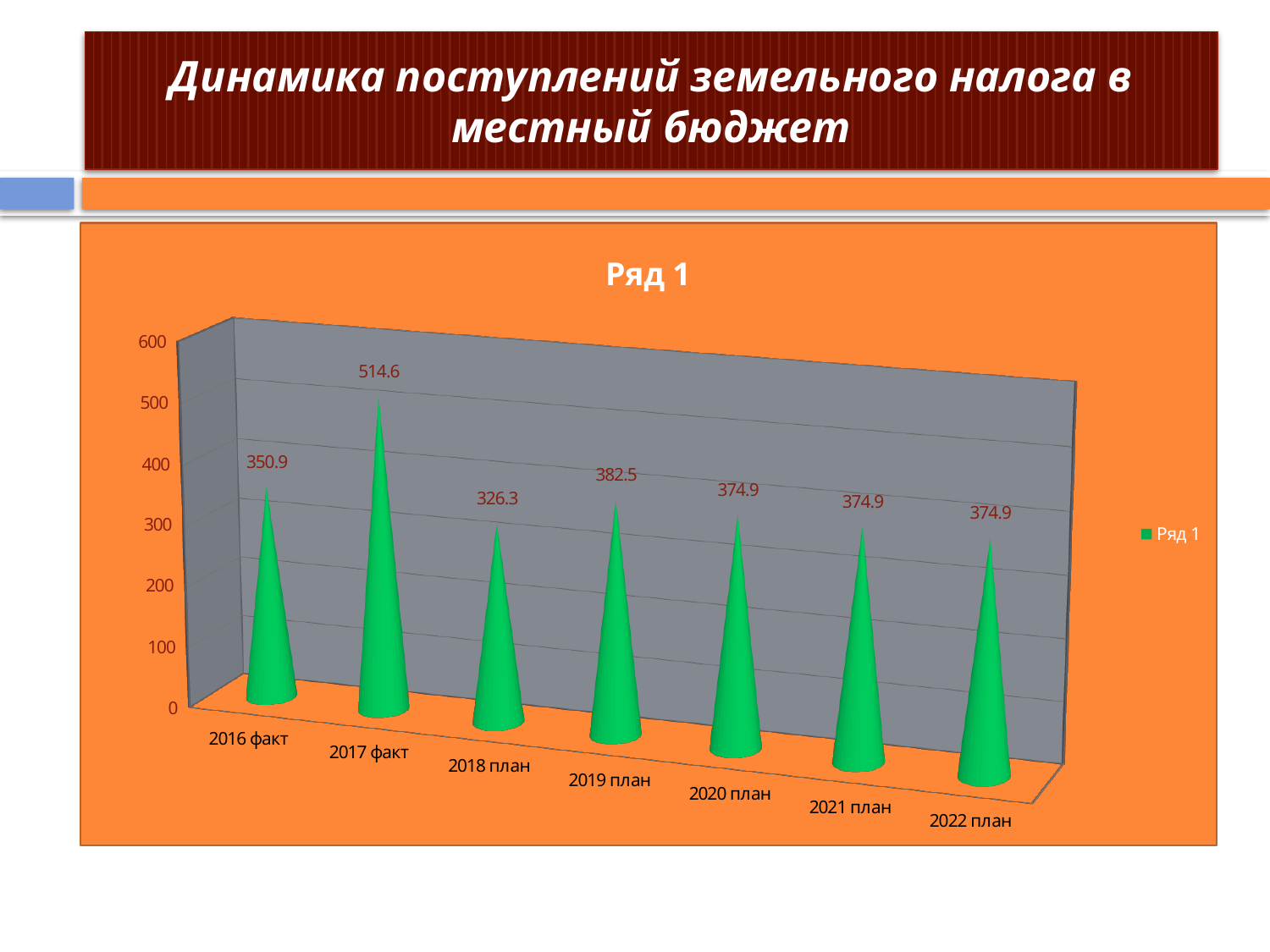
What is the value for 2019 план? 382.5 Which is larger, the value for 2019 план or the value for 2020 план? 2019 план What is the value for 2018 план? 326.3 How many categories are shown on the x axis? 7 What is the difference between the values for 2017 факт and 2016 факт? 163.7 What is the value for 2016 факт? 350.9 Which category has the highest value? 2017 факт What kind of chart is shown? bar chart What is the value for 2017 факт? 514.6 What is the title of the chart? Ряд 1 How many series does the legend list? 1 Which category has the lowest value? 2018 план